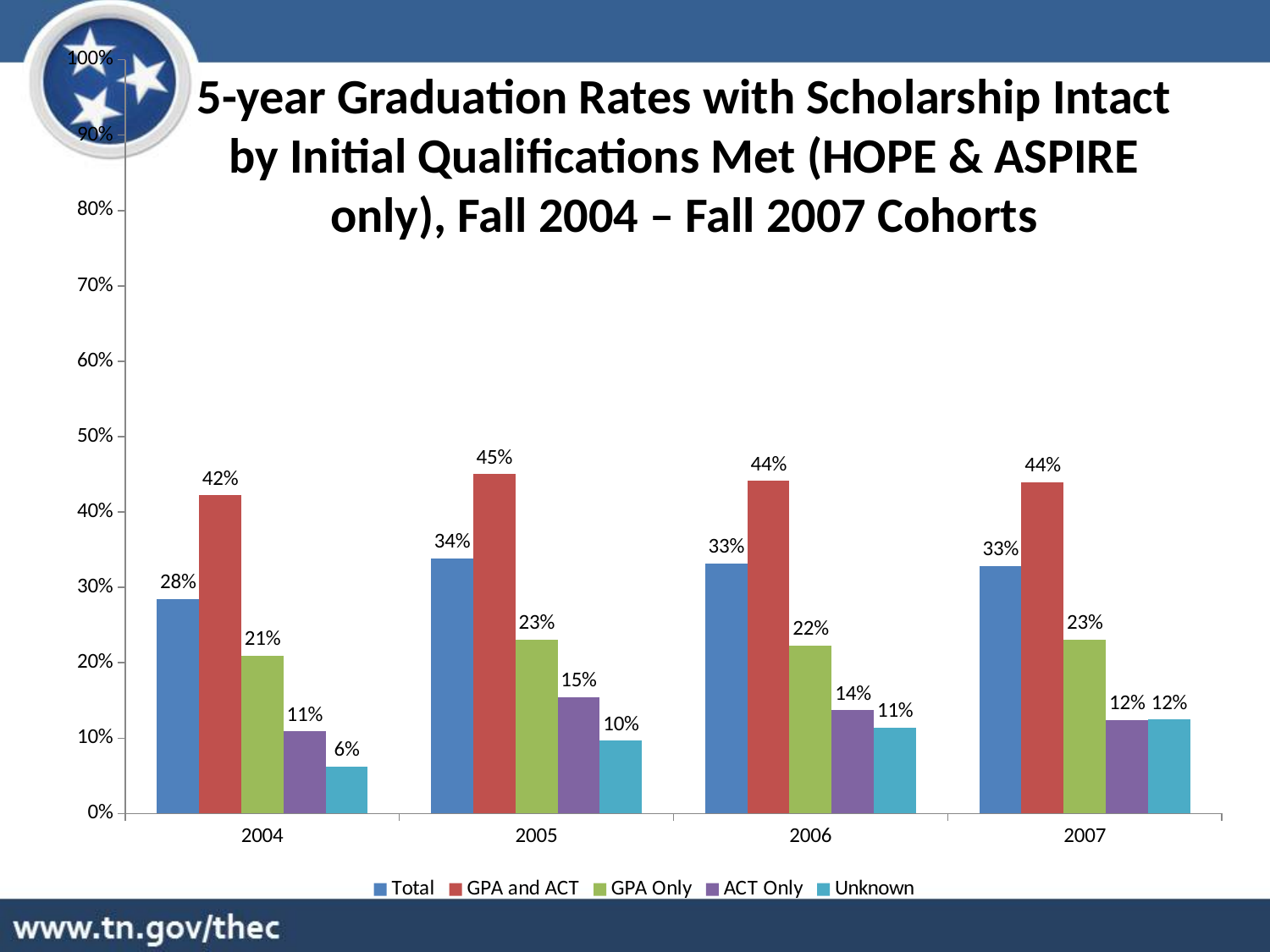
Which year has the lowest value for Unknown? 2004 What kind of chart is shown on the slide? bar chart What is the value for GPA and ACT in 2005? 45% Which series is shown in red in the legend? GPA and ACT How many series does the legend list? 5 What is the difference between the GPA and ACT value and the GPA Only value in 2004? 21% Which is larger in 2006: the ACT Only value or the Unknown value? ACT Only Is the Total value for 2005 greater or less than 30%? greater What is the value for Unknown in 2004? 6% What is the Total value for 2007? 33% How many years are shown on the x axis? 4 Which year has the highest value for GPA and ACT? 2005